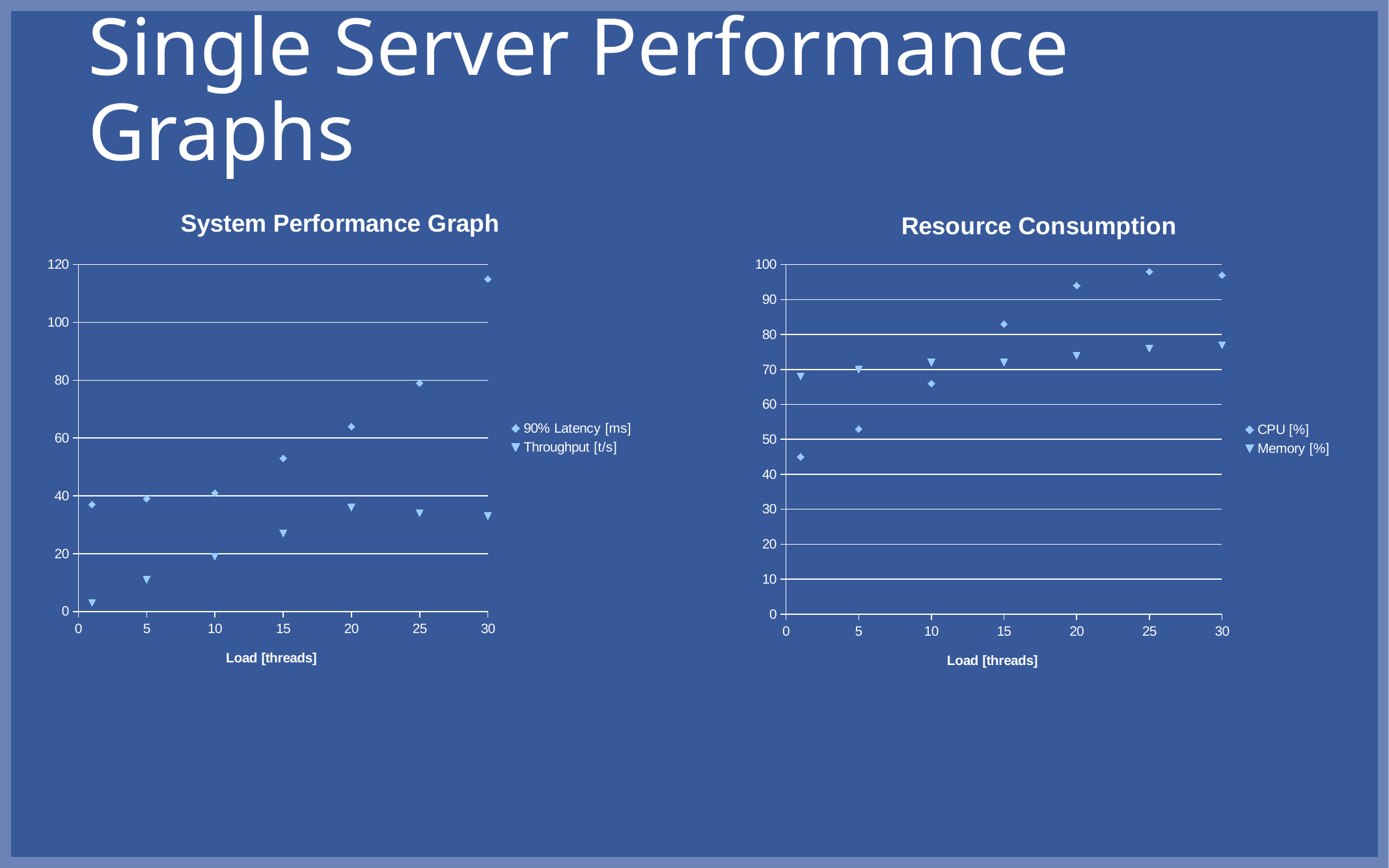
What is the x-axis label of the Resource Consumption chart? Load [threads] How many series does the legend of the System Performance Graph list? 2 What kind of chart is the System Performance Graph? scatter chart In the Resource Consumption chart, at 15 threads, which is higher: CPU [%] or Memory [%]? CPU [%] How many data points does the CPU [%] series have in the Resource Consumption chart? 7 How many series does the legend of the Resource Consumption chart list? 2 In the System Performance Graph, is the 90% Latency [ms] value at 30 threads greater or less than 100? greater In the System Performance Graph, does 90% Latency [ms] rise or fall as the load increases? rise In the System Performance Graph, is the Throughput [t/s] value at 5 threads greater or less than 20? less In the System Performance Graph, at which load does 90% Latency [ms] reach its highest value? 30 In the Resource Consumption chart, is the CPU [%] value at 1 thread greater or less than 50? less